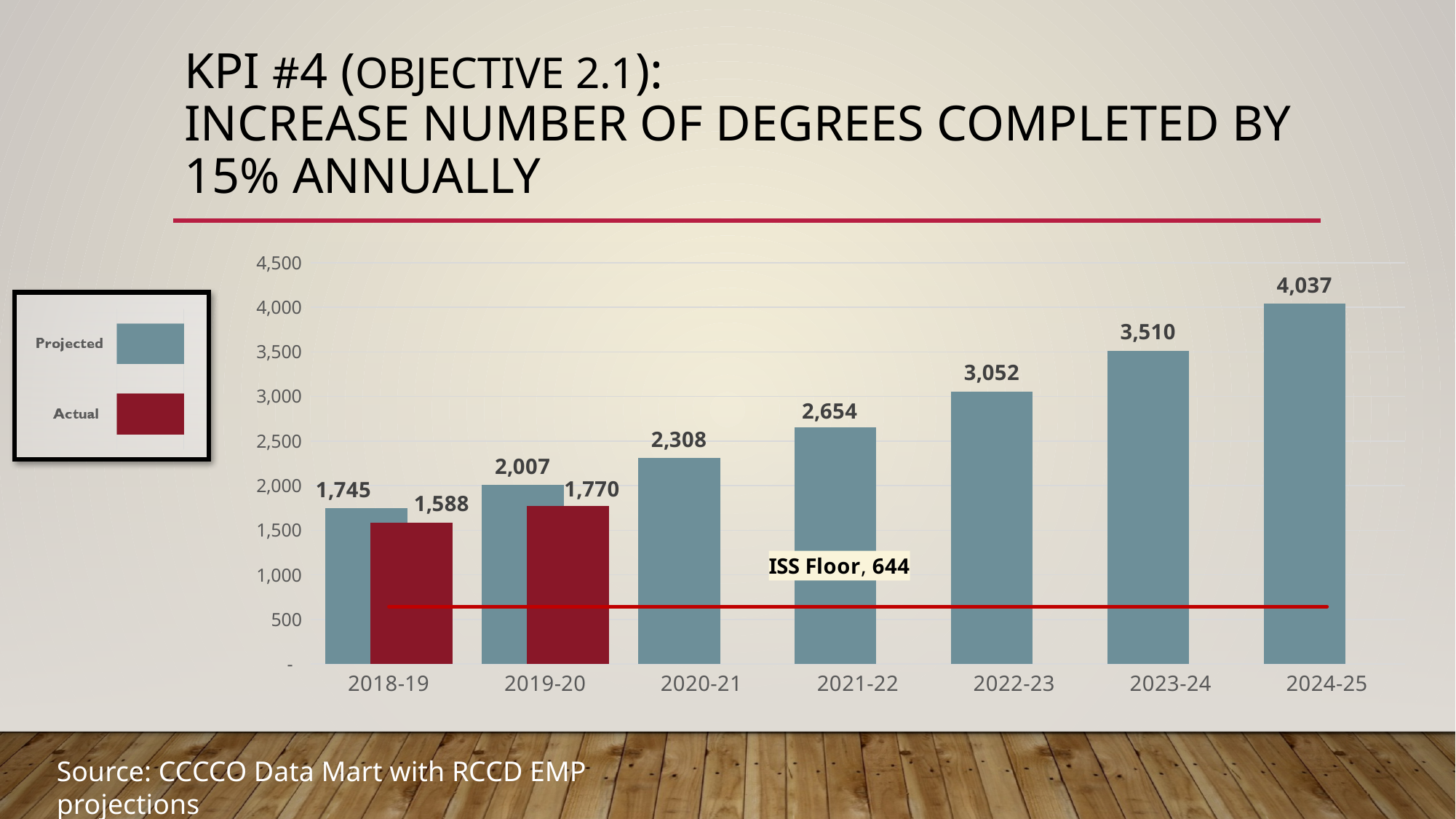
What is the Actual value for 2018-19? 1,588 What is the difference between the Projected and Actual values for 2019-20? 237 Which year has the lowest Projected value? 2018-19 What is the Projected value for 2024-25? 4,037 What value is labelled as the ISS Floor on the chart? 644 What is the Actual value for 2019-20? 1,770 How many series does the legend list? 2 Which year has the highest Projected value? 2024-25 What kind of chart is shown on the slide? Combination bar and line chart What is the Projected value for 2021-22? 2,654 Which is larger for 2018-19, the Projected value or the Actual value? Projected How many years are shown on the x axis? 7